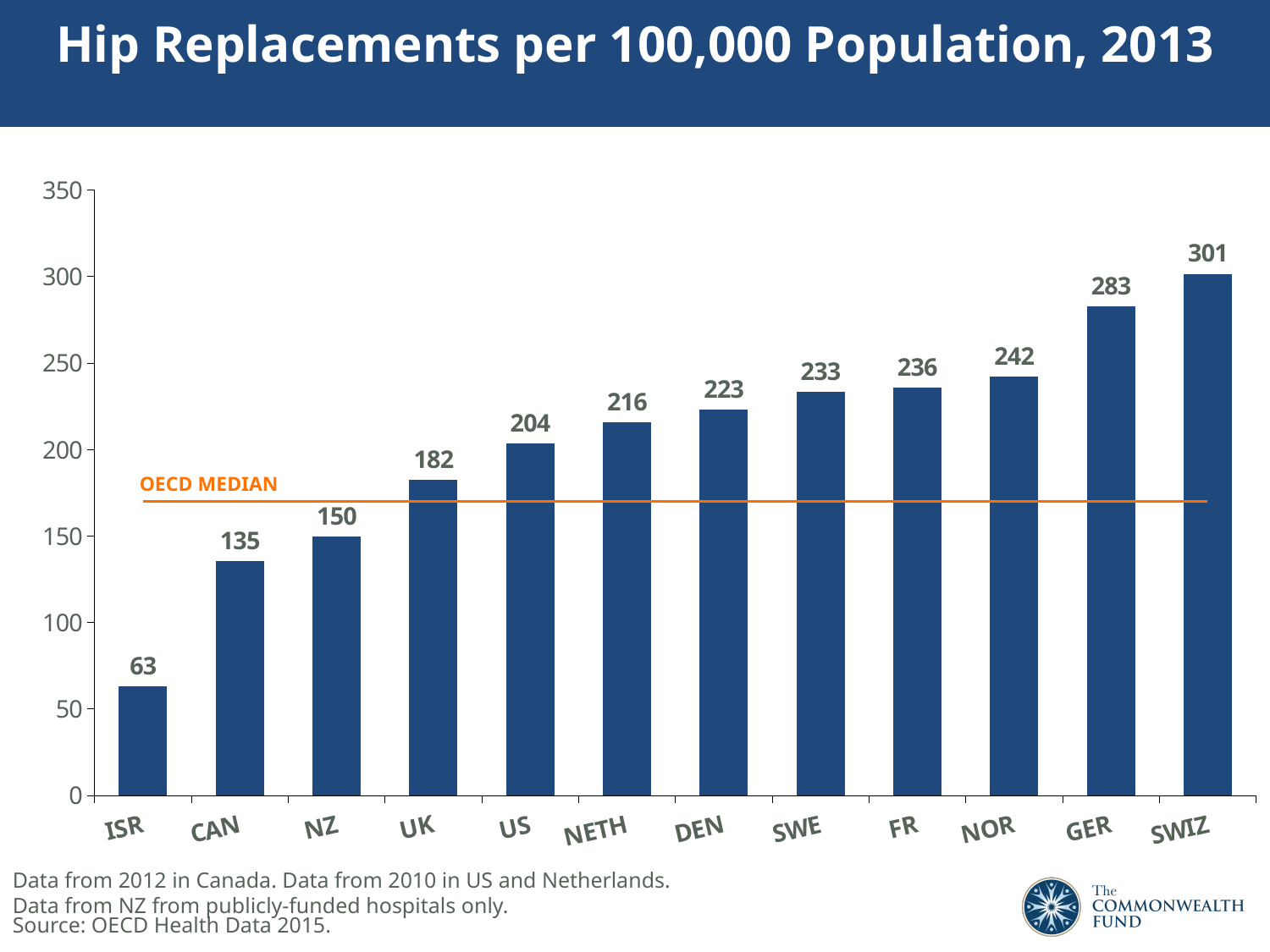
Which country has the lowest number of hip replacements per 100,000 population? ISR What is the value for Canada (CAN)? 135 How many countries are shown on the chart? 12 What is the title of the chart? Hip Replacements per 100,000 Population, 2013 What kind of chart is shown on the slide? bar chart Which is larger, the value for DEN or the value for NETH? DEN Do the values rise or fall from left to right along the x axis? rise What is the value for the UK? 182 What is the difference between the values for GER and NOR? 41 What is the label on the orange horizontal line? OECD MEDIAN Is the value for the OECD median line greater or less than 200? less Which country has the highest number of hip replacements per 100,000 population? SWIZ